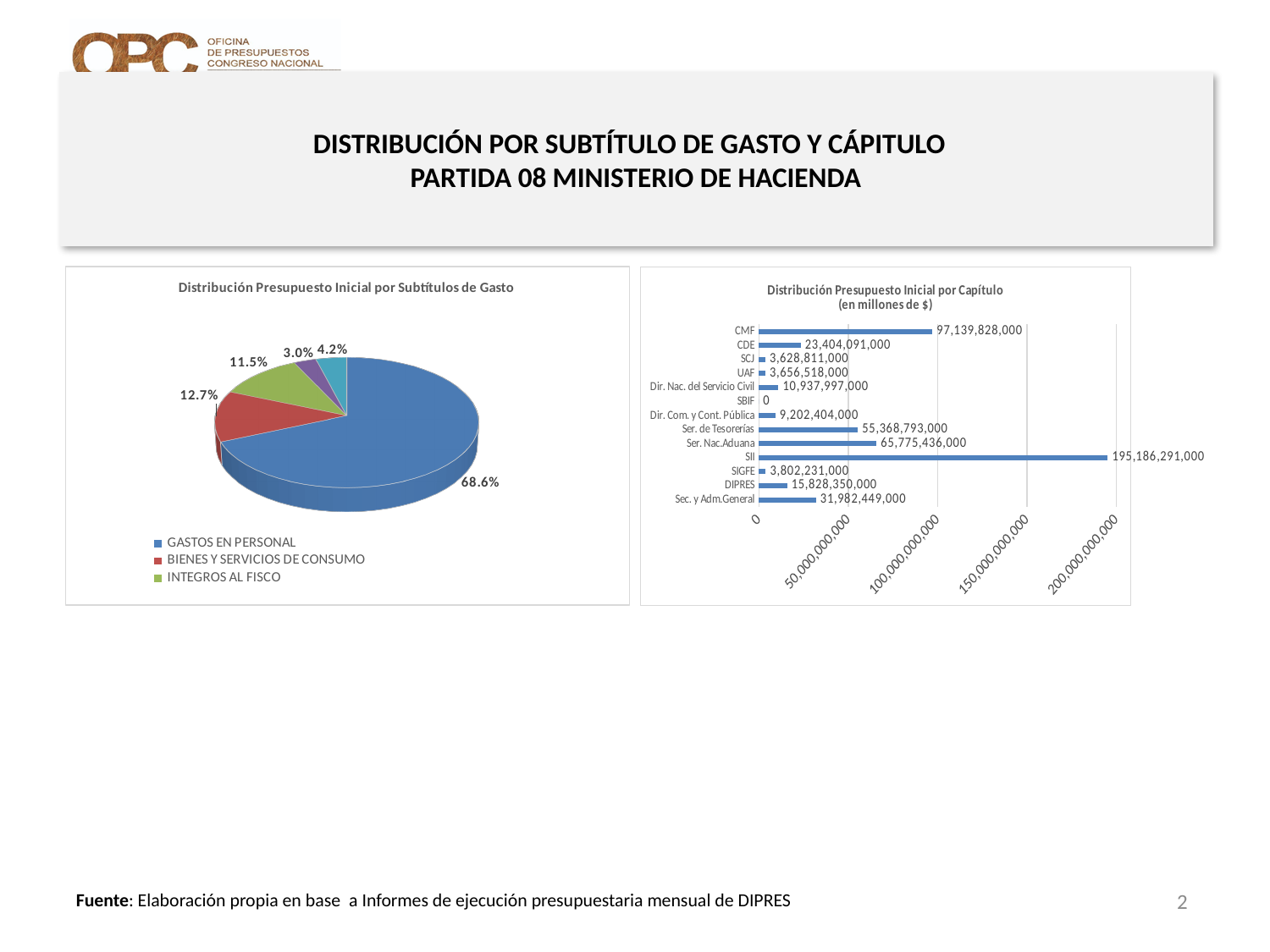
In the chart 'Distribución Presupuesto Inicial por Capítulo', what is the value for CMF? 97,139,828,000 In the chart 'Distribución Presupuesto Inicial por Capítulo', which category has the lowest value? SBIF In the chart 'Distribución Presupuesto Inicial por Capítulo', what is the value for DIPRES? 15,828,350,000 In the pie chart 'Distribución Presupuesto Inicial por Subtítulos de Gasto', what share does GASTOS EN PERSONAL have? 68.6% In the chart 'Distribución Presupuesto Inicial por Capítulo', is the value for Sec. y Adm.General greater or less than 50,000,000,000? less In the chart 'Distribución Presupuesto Inicial por Capítulo', what is the value for SII? 195,186,291,000 In the chart 'Distribución Presupuesto Inicial por Capítulo', which is larger, Ser. Nac.Aduana or Ser. de Tesorerías? Ser. Nac.Aduana What kind of chart is 'Distribución Presupuesto Inicial por Capítulo'? Bar chart How many entries does the legend of the pie chart 'Distribución Presupuesto Inicial por Subtítulos de Gasto' list? 3 In the chart 'Distribución Presupuesto Inicial por Capítulo', which category has the highest value? SII In the chart 'Distribución Presupuesto Inicial por Capítulo', what is the difference between the values for SII and CMF? 98,046,463,000 How many categories are shown in the chart 'Distribución Presupuesto Inicial por Capítulo'? 13